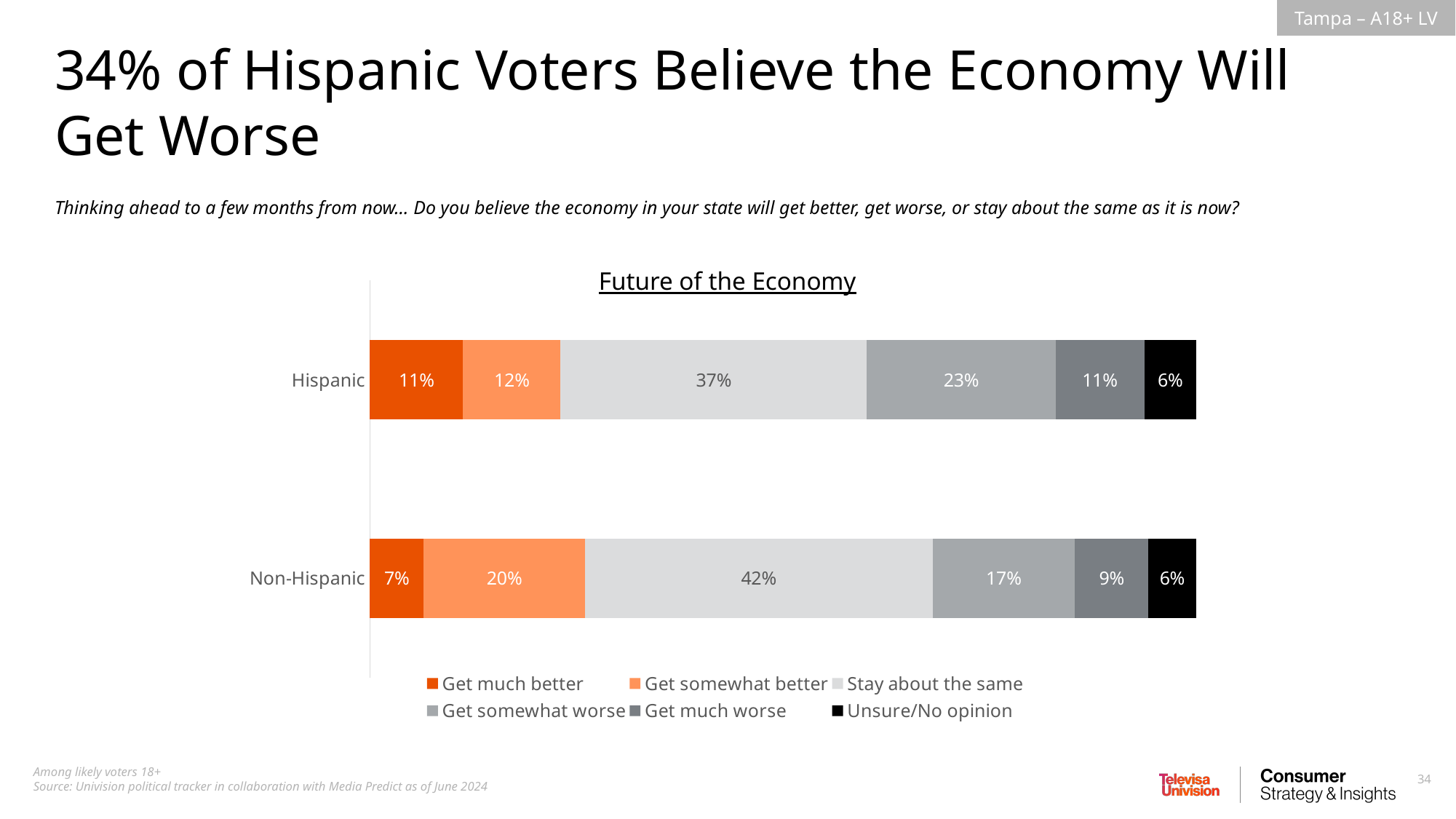
What is the difference between the Hispanic and Non-Hispanic shares for 'Get somewhat worse'? 6 percentage points What percentage of Hispanic voters say the economy will stay about the same? 37% What percentage of Non-Hispanic voters are unsure or have no opinion? 6% How many series does the legend list? 6 Which response has the smallest share among Hispanic voters? Unsure/No opinion What is the title of the chart? Future of the Economy What percentage of Hispanic voters say the economy will get much worse? 11% What type of chart is shown on the slide? Stacked bar chart What percentage of Non-Hispanic voters say the economy will get somewhat better? 20% Which group has a larger share saying the economy will get much better, Hispanic or Non-Hispanic? Hispanic How many categories (groups) are shown on the chart? 2 Which response has the largest share among Non-Hispanic voters? Stay about the same